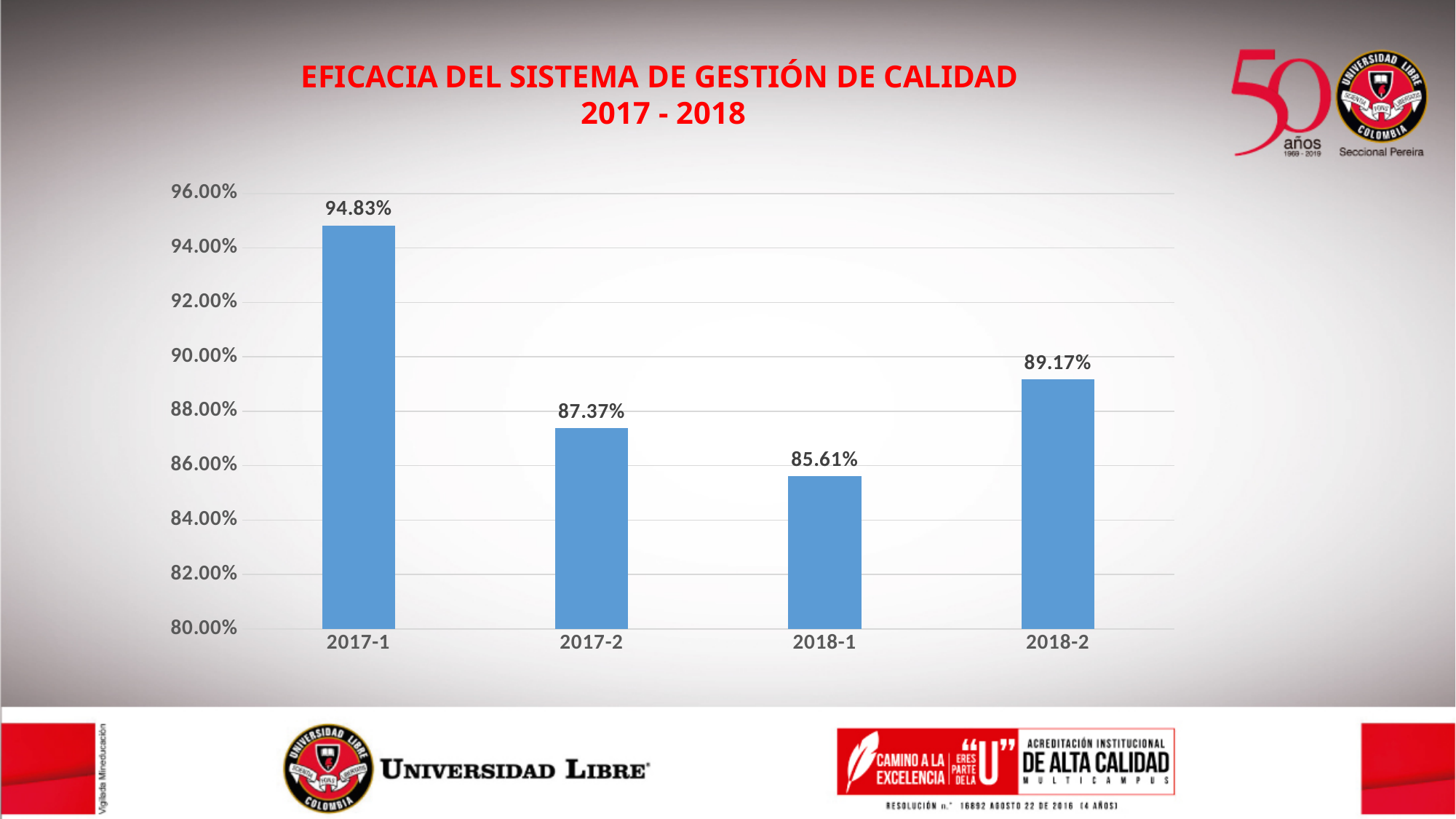
Which period has the lowest value? 2018-1 What kind of chart is shown on the slide? bar chart What is the title of the chart? EFICACIA DEL SISTEMA DE GESTIÓN DE CALIDAD 2017 - 2018 What is the value for 2018-1? 85.61% Which is larger, the value for 2017-2 or the value for 2018-2? 2018-2 Is the value for 2018-1 greater or less than 86.00%? less How many periods are shown on the x axis? 4 Which period has the highest value? 2017-1 What is the value for 2017-2? 87.37% What is the value for 2017-1? 94.83% What is the difference between the values for 2017-1 and 2018-1? 9.22% What is the value for 2018-2? 89.17%